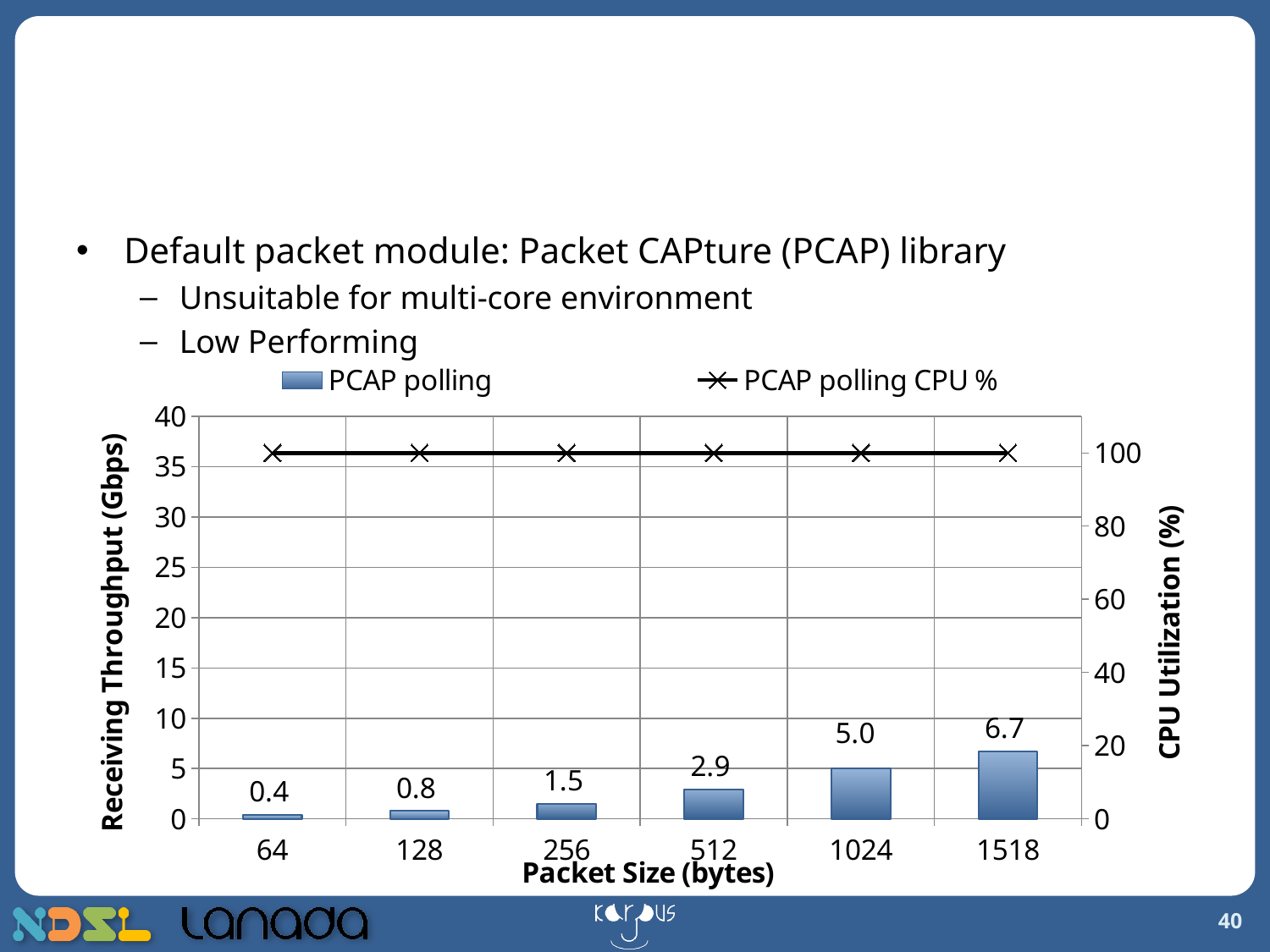
Which packet size has the highest PCAP polling receiving throughput? 1518 What is the label of the right-hand vertical axis? CPU Utilization (%) What is the PCAP polling receiving throughput for a packet size of 512 bytes? 2.9 What is the PCAP polling receiving throughput for a packet size of 64 bytes? 0.4 Which packet size has the lowest PCAP polling receiving throughput? 64 How many packet sizes are shown on the x axis? 6 What kind of chart is shown on the slide? Combined bar and line chart How many series does the legend list? 2 What is the difference in PCAP polling throughput between packet sizes 1518 and 1024 bytes? 1.7 Does the PCAP polling throughput rise or fall as packet size increases? Rise Which has a higher PCAP polling throughput: packet size 256 or packet size 128? 256 What is the PCAP polling receiving throughput for a packet size of 1518 bytes? 6.7